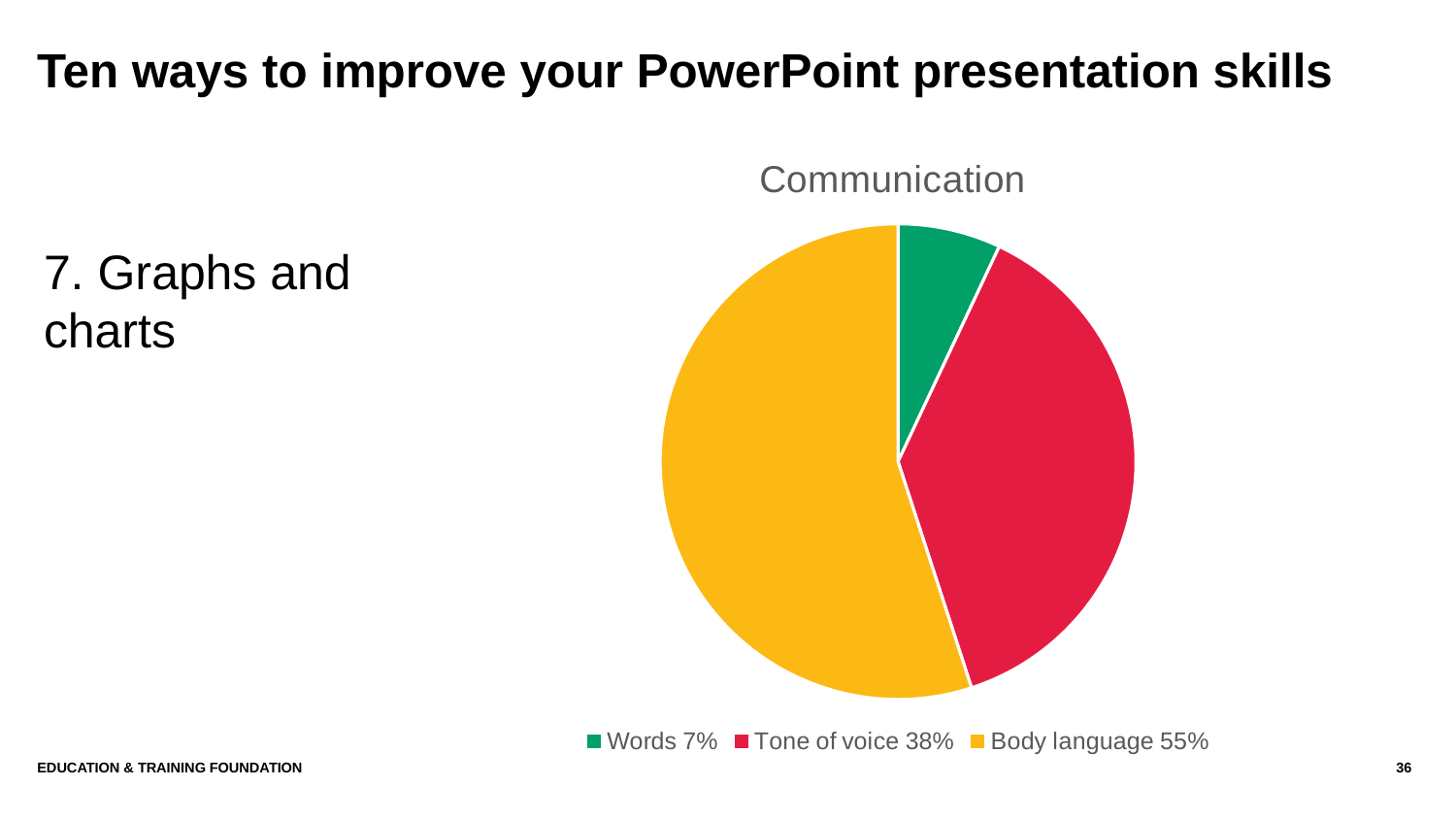
What percentage does the legend give for Body language? 55% Which is larger, the slice for Tone of voice or the slice for Words? Tone of voice Which category has the largest slice of the pie? Body language What is the title of the chart? Communication What colour is the Body language slice? Yellow How many slices does the pie chart have? 3 Which category has the smallest slice of the pie? Words What kind of chart is shown on the slide? Pie chart What percentage does the legend give for Tone of voice? 38% What is the difference in percentage points between Body language and Tone of voice? 17 What is the combined share of Words and Tone of voice? 45% What percentage does the legend give for Words? 7%